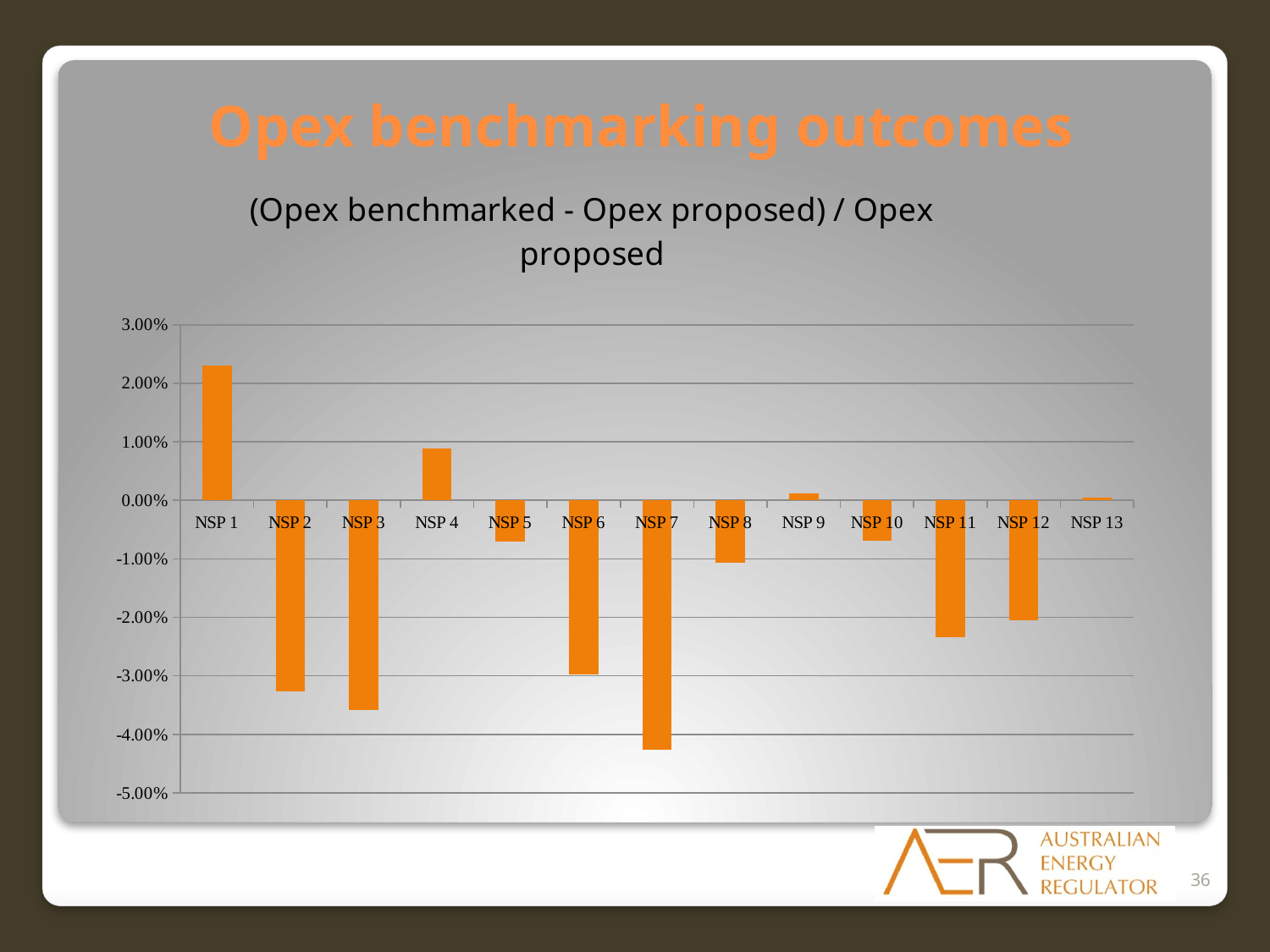
How many NSP categories are plotted on the x axis? 13 What kind of chart is shown on the slide? bar chart Which has the larger value, NSP 2 or NSP 3? NSP 2 Is the value for NSP 4 greater or less than 1.00%? less Which NSP has the lowest value? NSP 7 What is the title of the chart? (Opex benchmarked - Opex proposed) / Opex proposed Is the value for NSP 11 greater or less than -2.00%? less Is the value for NSP 7 greater or less than -4.00%? less Which NSP has the highest value? NSP 1 How many NSPs have a positive value (bar above 0.00%)? 4